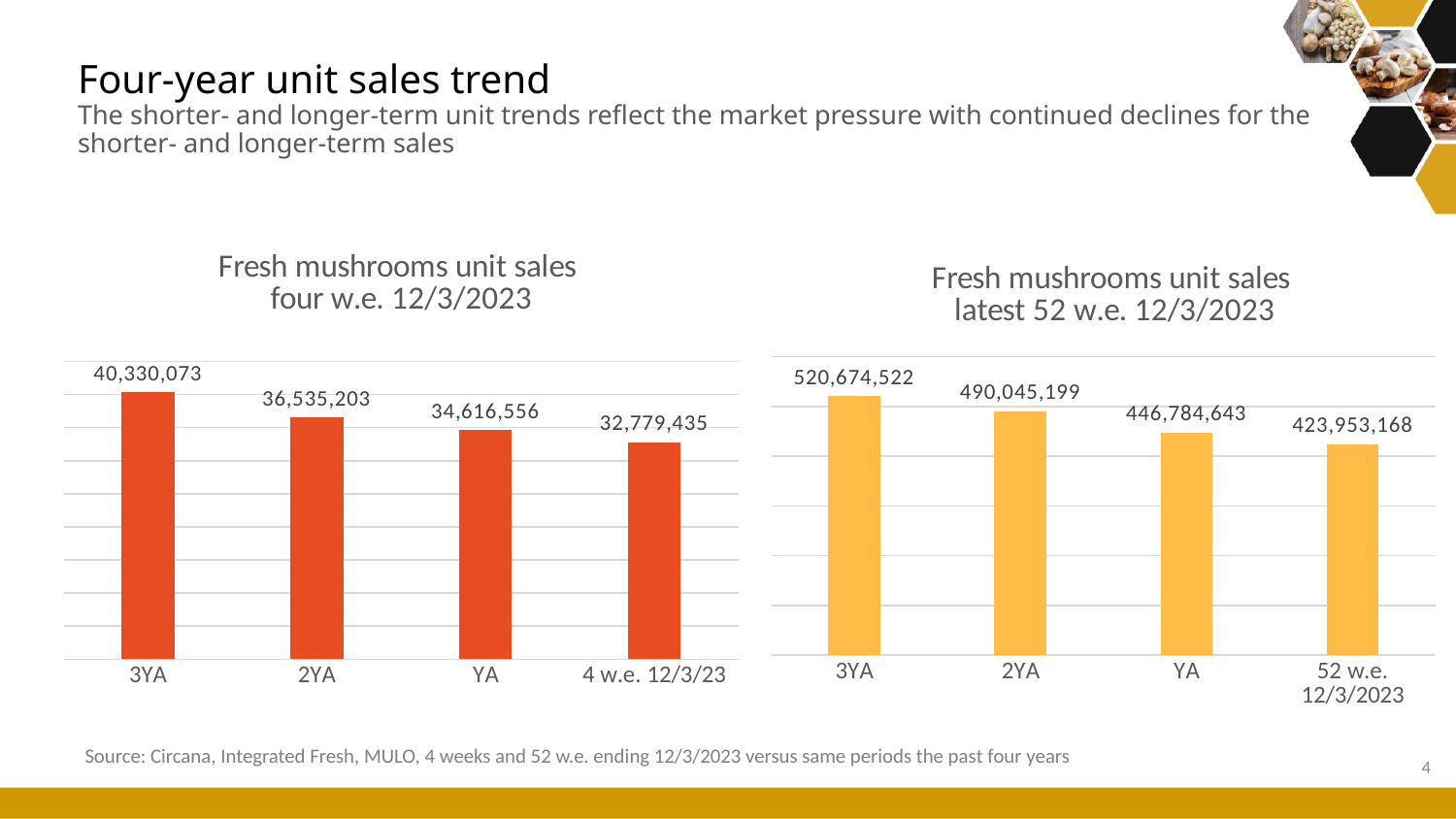
What type of chart is the 'Fresh mushrooms unit sales latest 52 w.e. 12/3/2023' chart? Bar chart In the 'Fresh mushrooms unit sales four w.e. 12/3/2023' chart, what is the value for 3YA? 40,330,073 In the 'Fresh mushrooms unit sales four w.e. 12/3/2023' chart, do the values rise or fall from 3YA to 4 w.e. 12/3/23? Fall In the 'Fresh mushrooms unit sales latest 52 w.e. 12/3/2023' chart, what is the value for 52 w.e. 12/3/2023? 423,953,168 In the 'Fresh mushrooms unit sales four w.e. 12/3/2023' chart, what is the value for 4 w.e. 12/3/23? 32,779,435 In the 'Fresh mushrooms unit sales four w.e. 12/3/2023' chart, what is the difference between the 3YA value and the 4 w.e. 12/3/23 value? 7,550,638 In the 'Fresh mushrooms unit sales latest 52 w.e. 12/3/2023' chart, which period has the lowest unit sales? 52 w.e. 12/3/2023 How many bars are shown in the 'Fresh mushrooms unit sales four w.e. 12/3/2023' chart? 4 In the 'Fresh mushrooms unit sales latest 52 w.e. 12/3/2023' chart, what is the value for YA? 446,784,643 In the 'Fresh mushrooms unit sales latest 52 w.e. 12/3/2023' chart, what is the difference between the 3YA value and the 2YA value? 30,629,323 In the 'Fresh mushrooms unit sales four w.e. 12/3/2023' chart, which period has the highest unit sales? 3YA In the 'Fresh mushrooms unit sales latest 52 w.e. 12/3/2023' chart, which is larger, the value for 2YA or the value for YA? 2YA